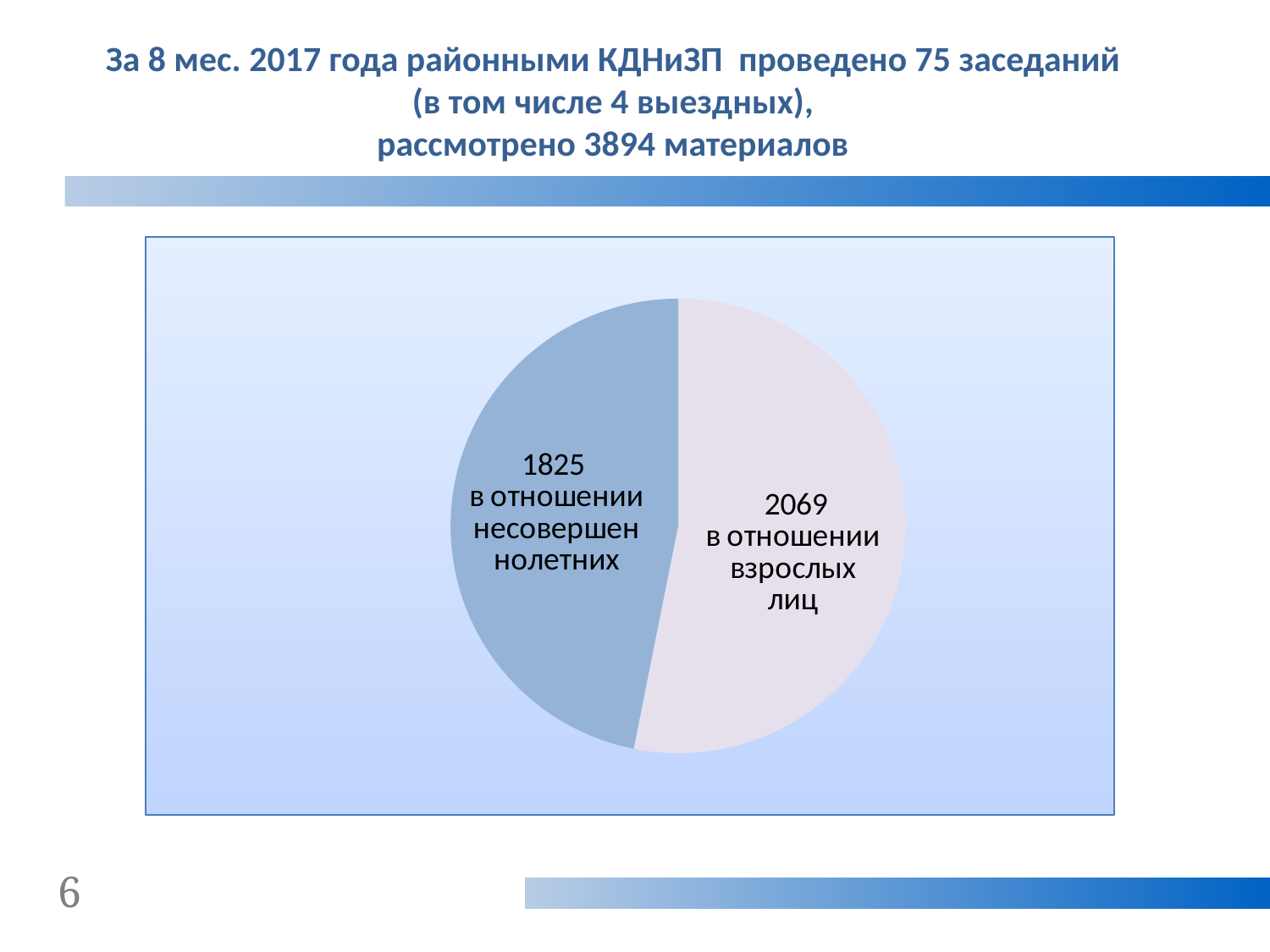
How many materials were considered in relation to minors (в отношении несовершеннолетних) according to the pie chart? 1825 Which slice of the pie chart is the largest? в отношении взрослых лиц What is the difference between the number of materials concerning adults and the number concerning minors? 244 How many materials were considered in relation to adults (в отношении взрослых лиц) according to the pie chart? 2069 What colour is the slice for materials concerning minors (в отношении несовершеннолетних)? blue What is the total of the two values shown in the pie chart? 3894 What type of chart is shown on the slide? pie chart Is the value for materials concerning minors greater or less than 2000? less Which is larger: the number of materials concerning minors or the number concerning adults? в отношении взрослых лиц How many slices does the pie chart have? 2 Which slice of the pie chart is the smallest? в отношении несовершеннолетних What share of the pie does the slice for adults (в отношении взрослых лиц) represent? 53.1%